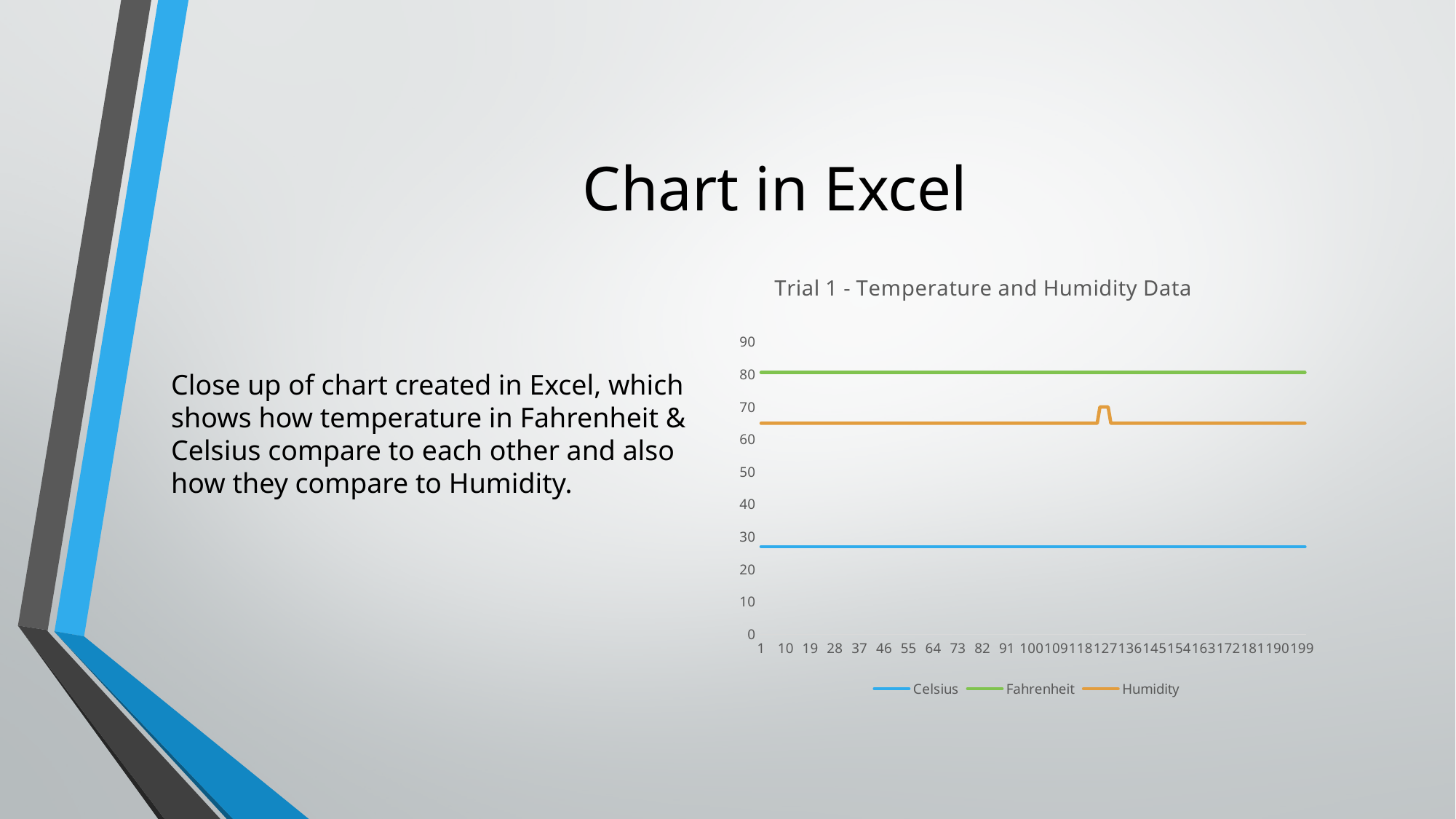
Which is larger, the Fahrenheit line or the Humidity line? Fahrenheit Which series has the lowest values on the chart? Celsius Is the Celsius line greater or less than 30? less Which series has the highest values on the chart? Fahrenheit Does the Celsius line rise, fall, or stay flat across the x axis? stays flat Is the Humidity value at x = 1 greater or less than 60? greater Which series are listed in the chart legend? Celsius, Fahrenheit, Humidity What kind of chart is shown on the slide? line chart Is the Fahrenheit line greater or less than 70? greater How many series does the chart legend list? 3 Which is larger, the Humidity line or the Celsius line? Humidity What is the title of the chart? Trial 1 - Temperature and Humidity Data